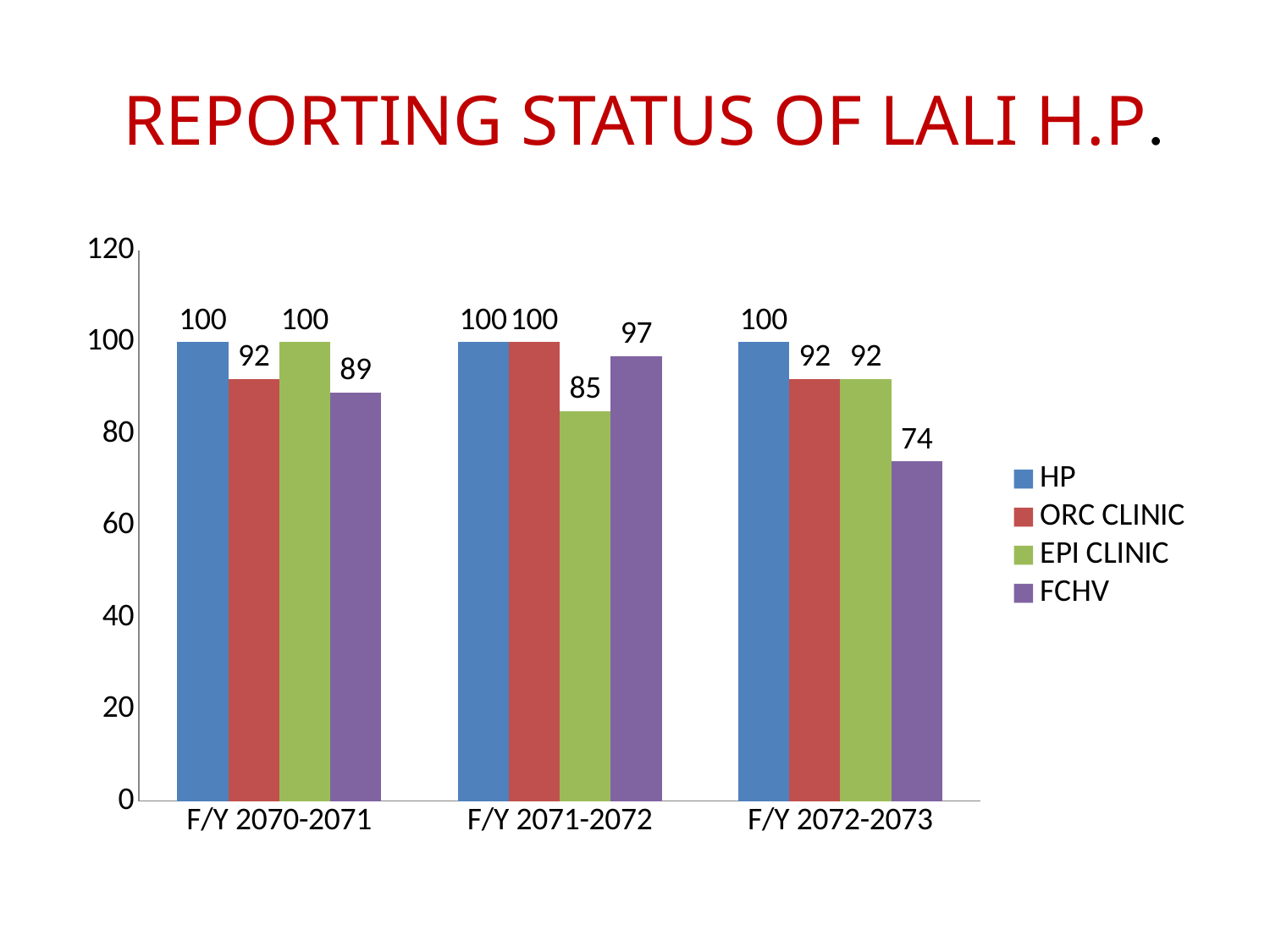
What is the value for ORC CLINIC in F/Y 2070-2071? 92 Does the FCHV value rise or fall from F/Y 2071-2072 to F/Y 2072-2073? Fall What is the value for EPI CLINIC in F/Y 2071-2072? 85 Which series has the lowest value in F/Y 2072-2073? FCHV Which is larger, the EPI CLINIC value in F/Y 2070-2071 or in F/Y 2071-2072? F/Y 2070-2071 How many fiscal year categories are shown on the x axis? 3 What is the difference between the FCHV value in F/Y 2071-2072 and in F/Y 2070-2071? 8 What is the value for FCHV in F/Y 2072-2073? 74 How many series does the legend list? 4 What is the difference between the HP value and the FCHV value in F/Y 2072-2073? 26 Which series has the lowest value in F/Y 2071-2072? EPI CLINIC What kind of chart is shown on the slide? Bar chart